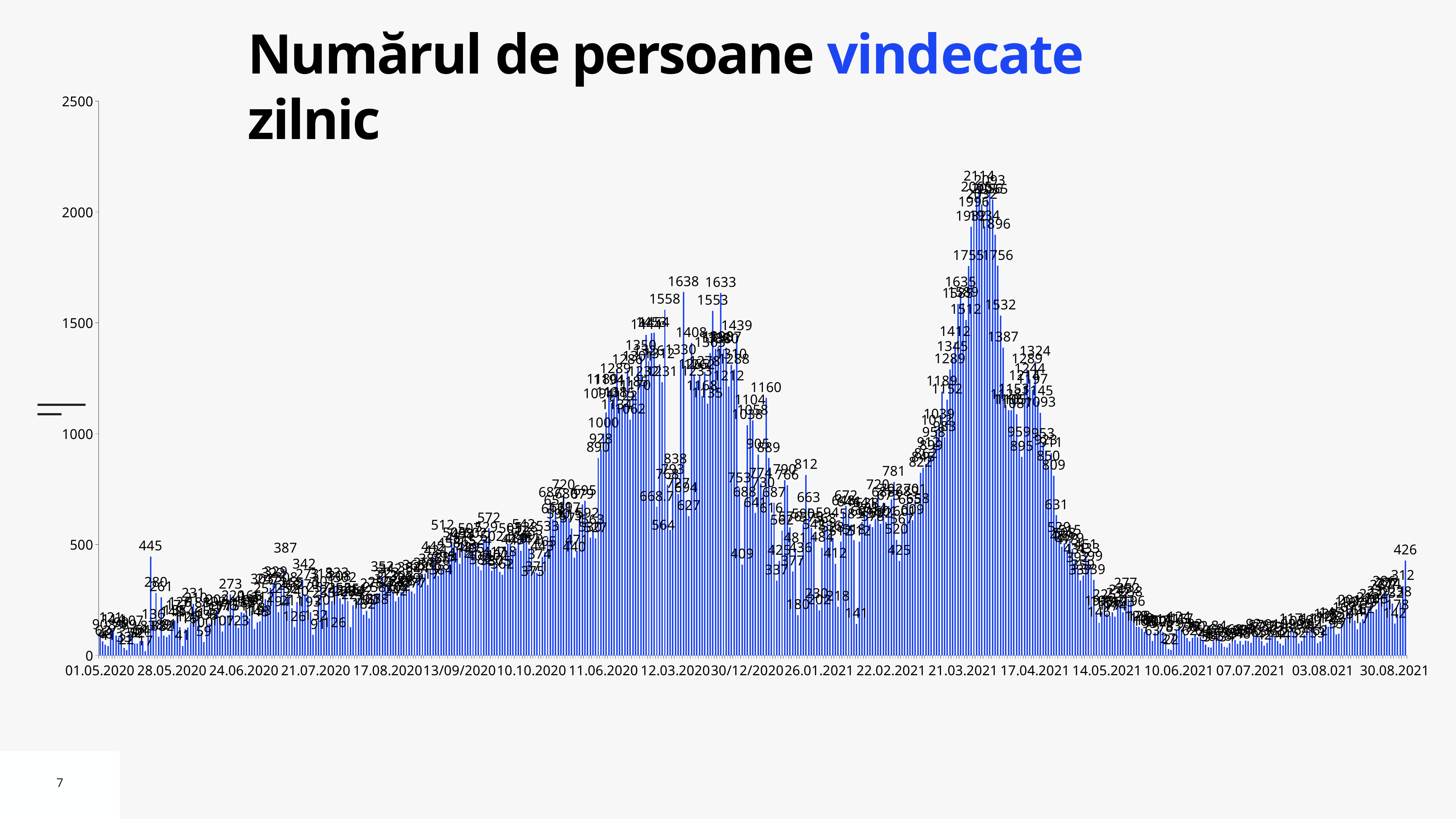
What is the difference between the highest labelled value (2114) and the value of the last bar (426)? 1688 Is the tallest bar, near 17.04.2021, greater or less than 2000? greater Which is higher: the peak labelled 2114 in spring 2021 or the peak labelled 1638 in late 2020? 2114 Is the tallest bar near 28.05.2020 greater or less than 500? less What is the title of the chart on the slide? Numărul de persoane vindecate zilnic What is the value of the tallest bar in the first month of the chart, near 28.05.2020? 445 What kind of chart is shown on the slide? bar chart What is the maximum value shown on the vertical axis? 2500 Do the values rise or fall between 10.06.2021 and 30.08.2021? rise What is the value of the last bar, at 30.08.2021? 426 Is the value of the last bar (30.08.2021) greater or less than 500? less What is the highest value labelled on the chart? 2114